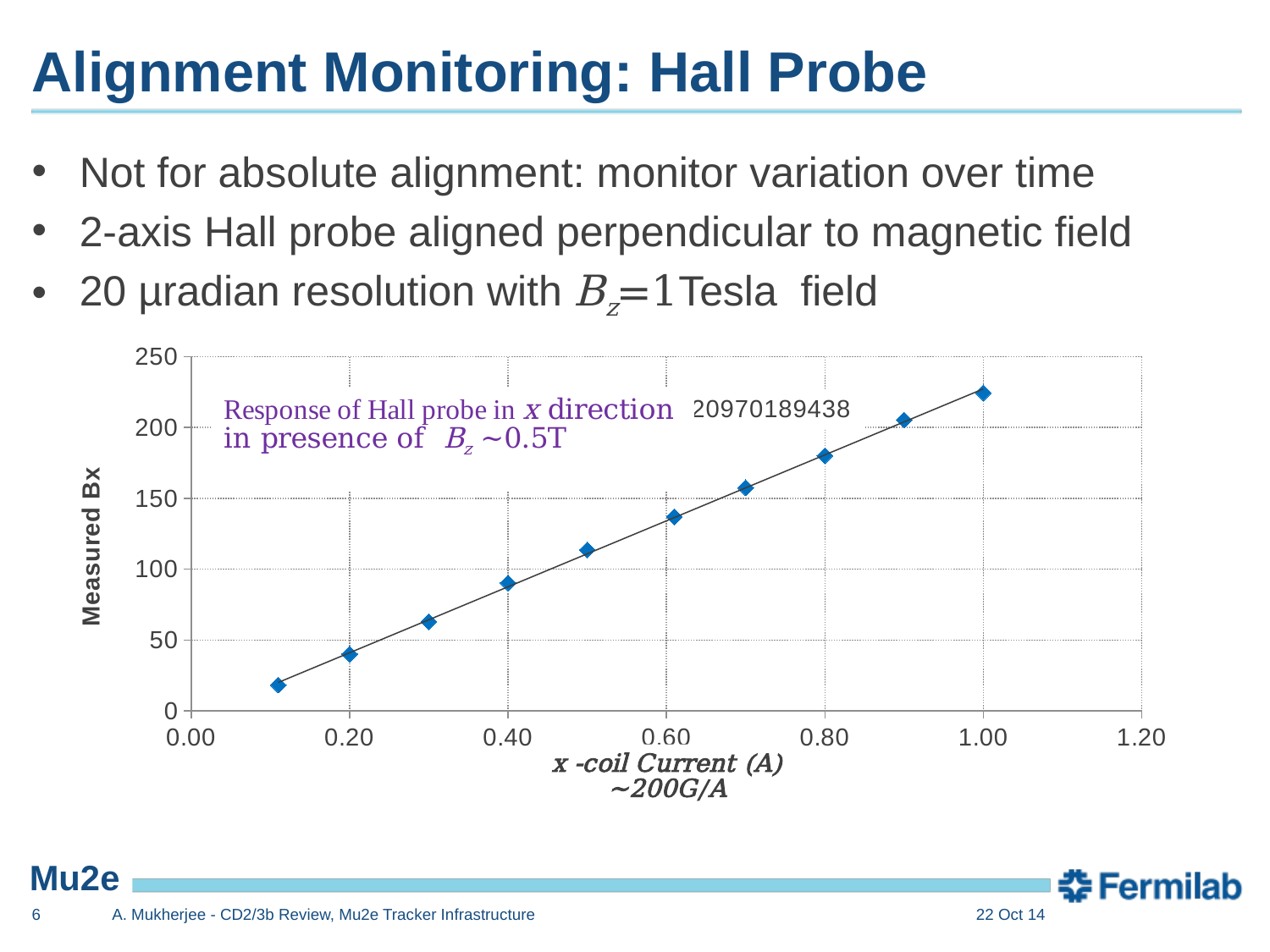
Is the Measured Bx value at an x-coil current of 0.40 A greater or less than 100? less How many data points are plotted in the chart? 10 Is the Measured Bx value at an x-coil current of 0.20 A greater or less than 50? less Is the Measured Bx value at an x-coil current of 1.00 A greater or less than 200? greater Do the Measured Bx values rise or fall as the x-coil current increases? rise Which x-coil current has the highest Measured Bx value? 1.00 What is the label of the horizontal axis of the chart? x -coil Current (A) ~200G/A Which has a larger Measured Bx value: the point at 0.20 A or the point at 0.60 A? 0.60 A What is the label of the vertical axis of the chart? Measured Bx What kind of chart is shown on the slide? scatter chart